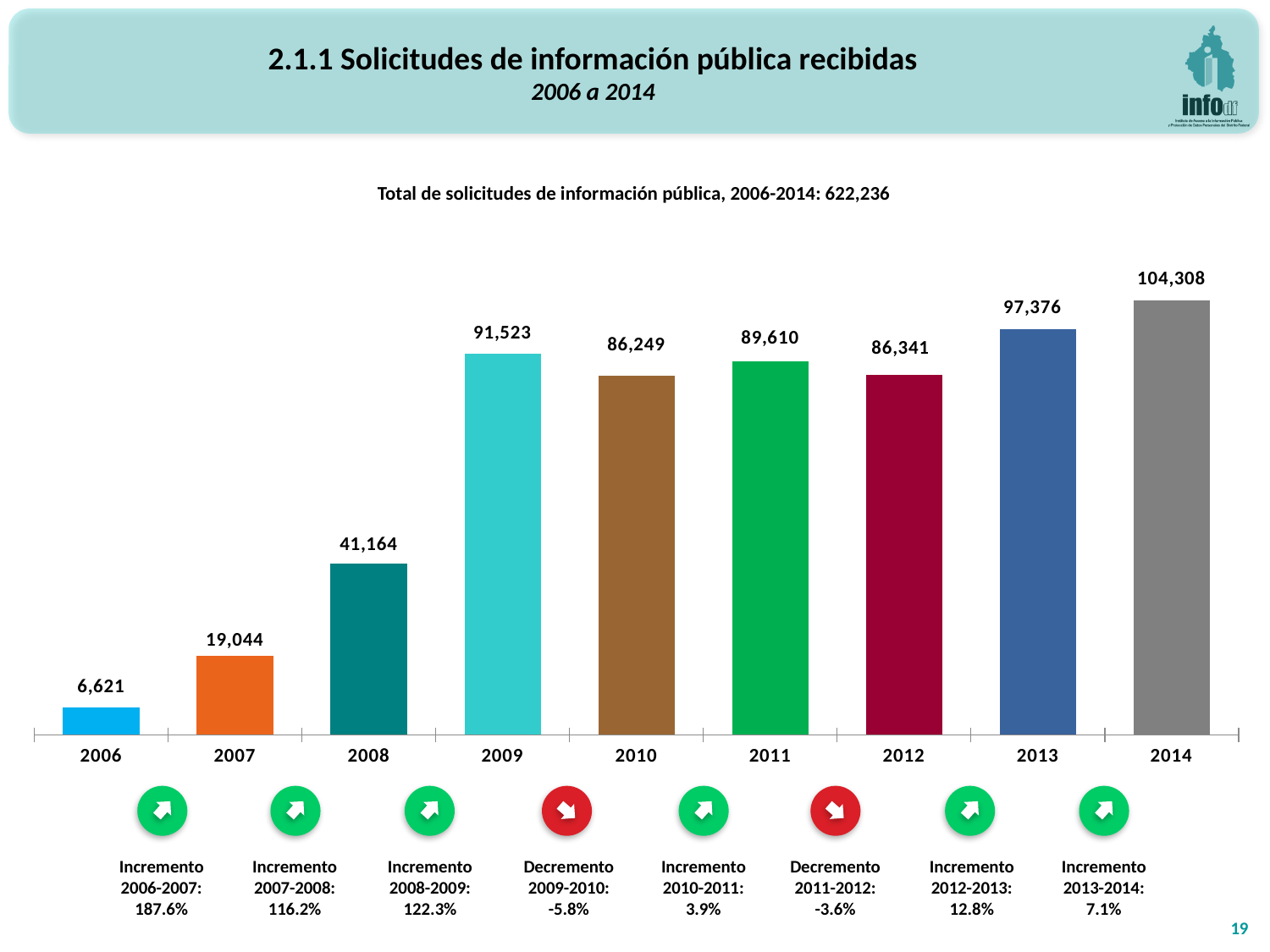
What is the difference between the values for 2009 and 2010? 5,274 Which year has the lowest value? 2006 What is the value for 2006? 6,621 Which is larger, the value for 2011 or the value for 2012? 2011 What is the difference between the values for 2014 and 2013? 6,932 Which year has the highest value? 2014 What total for 2006-2014 is stated above the chart? 622,236 What kind of chart is this? Bar chart What is the value for 2013? 97,376 Do the values generally rise or fall from 2006 to 2014? Rise What is the value for 2009? 91,523 How many years are shown on the x axis? 9